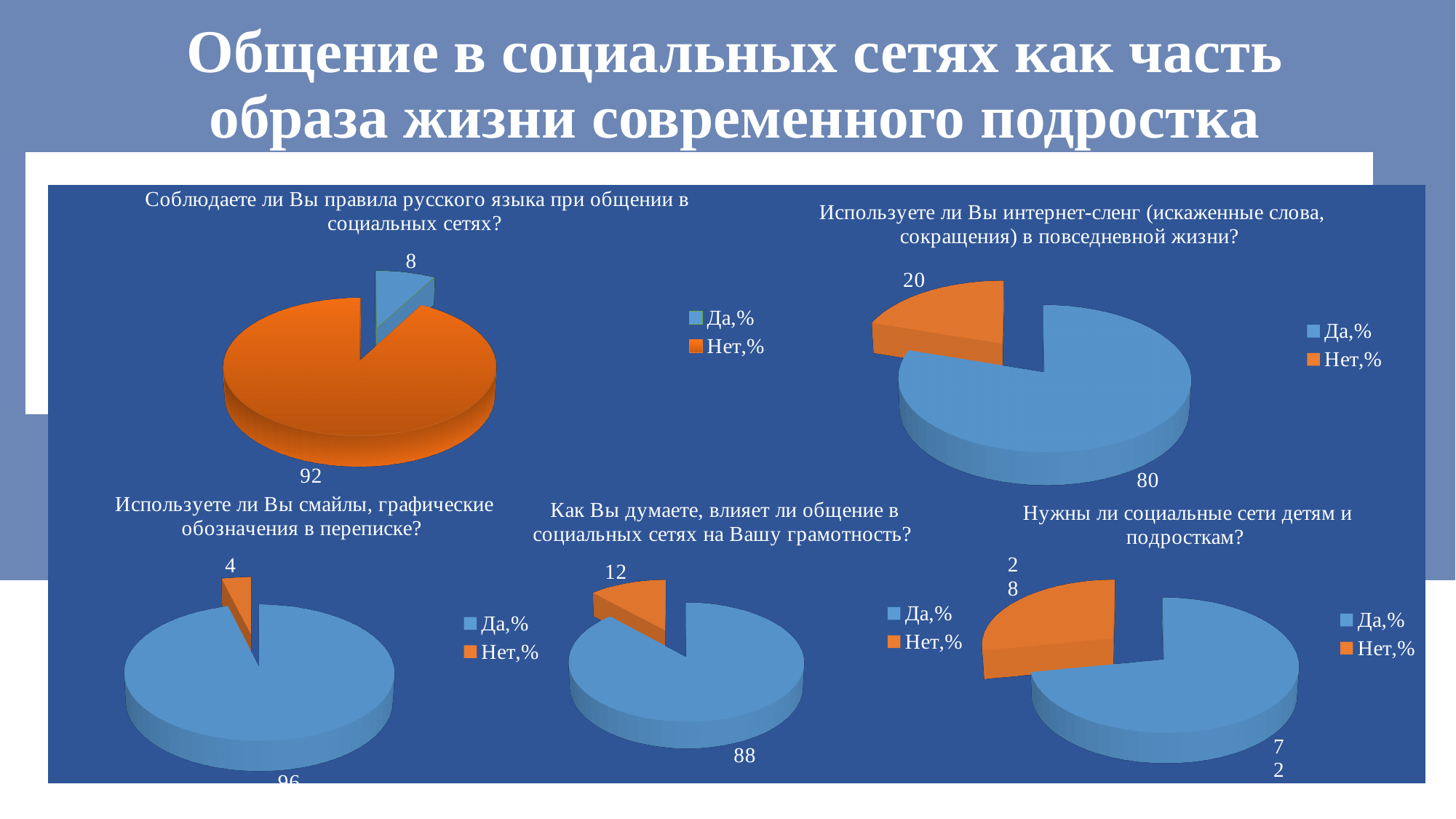
In the chart titled "Соблюдаете ли Вы правила русского языка при общении в социальных сетях?", what is the value for Нет,%? 92 In the chart titled "Как Вы думаете, влияет ли общение в социальных сетях на Вашу грамотность?", which is larger, Да,% or Нет,%? Да,% In the chart titled "Нужны ли социальные сети детям и подросткам?", what is the difference between Да,% and Нет,%? 44 In the chart titled "Как Вы думаете, влияет ли общение в социальных сетях на Вашу грамотность?", what is the value for Да,%? 88 In the chart titled "Нужны ли социальные сети детям и подросткам?", what is the value for Нет,%? 28 In the chart titled "Используете ли Вы смайлы, графические обозначения в переписке?", what is the difference between Да,% and Нет,%? 92 In the chart titled "Используете ли Вы интернет-сленг (искаженные слова, сокращения) в повседневной жизни?", which category is the smallest? Нет,% How many series does the legend list for the chart titled "Нужны ли социальные сети детям и подросткам?"? 2 What kind of chart is the chart titled "Соблюдаете ли Вы правила русского языка при общении в социальных сетях?"? Pie chart In the chart titled "Соблюдаете ли Вы правила русского языка при общении в социальных сетях?", what is the value for Да,%? 8 In the chart titled "Используете ли Вы интернет-сленг (искаженные слова, сокращения) в повседневной жизни?", what is the value for Да,%? 80 In the chart titled "Используете ли Вы смайлы, графические обозначения в переписке?", what is the value for Нет,%? 4